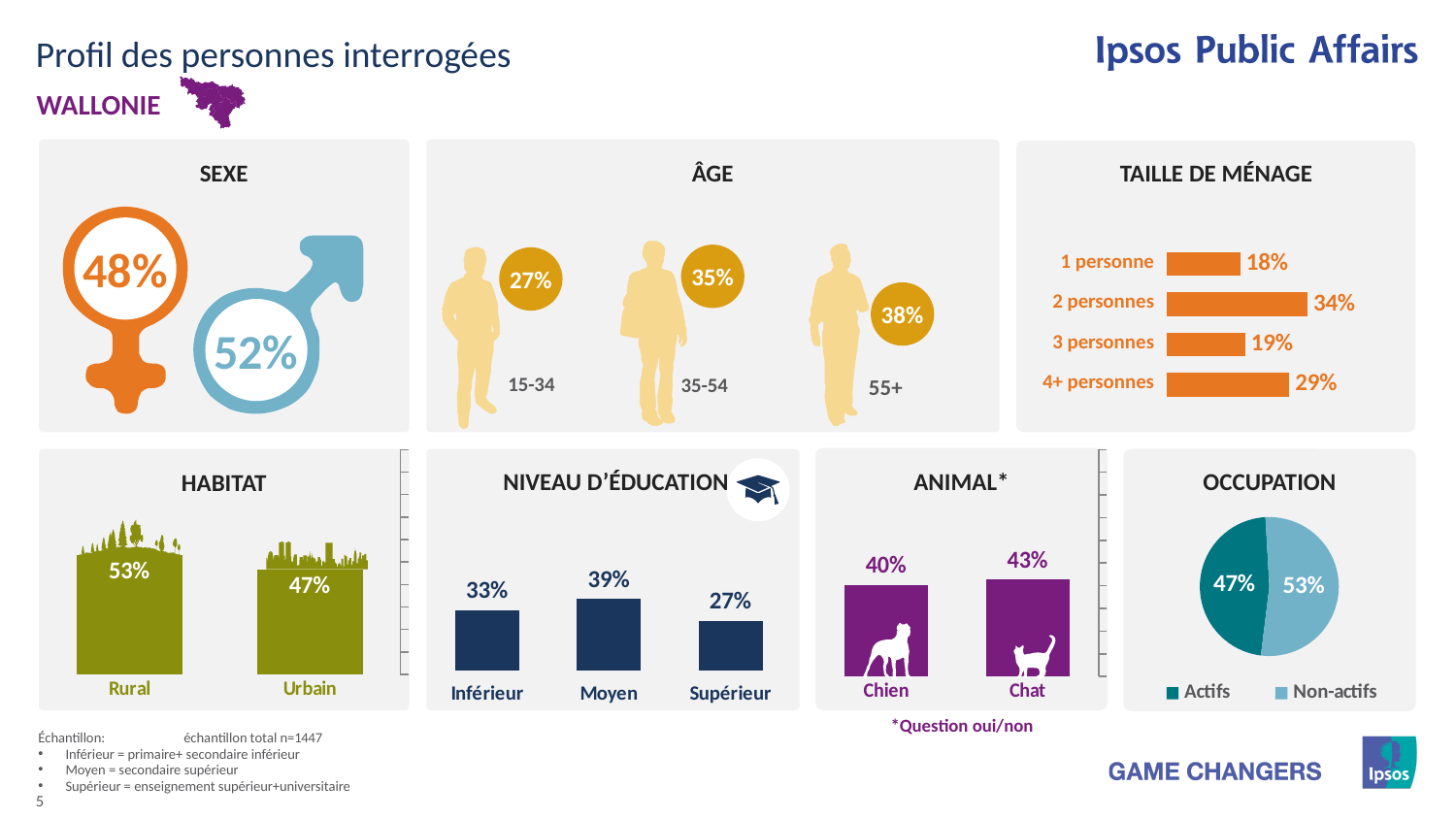
In the TAILLE DE MÉNAGE chart, what is the value for 2 personnes? 34% How many entries does the legend of the OCCUPATION pie chart list? 2 In the TAILLE DE MÉNAGE chart, which household size has the lowest value? 1 personne In the OCCUPATION pie chart, what share is Non-actifs? 53% In the HABITAT chart, what is the value for Rural? 53% What kind of chart is the TAILLE DE MÉNAGE chart? bar chart How many categories does the TAILLE DE MÉNAGE chart show? 4 In the ANIMAL chart, which is larger, Chien or Chat? Chat In the ANIMAL chart, what is the difference between Chat and Chien? 3% In the NIVEAU D'ÉDUCATION chart, which level has the highest value? Moyen In the TAILLE DE MÉNAGE chart, what is the difference between 4+ personnes and 3 personnes? 10% In the NIVEAU D'ÉDUCATION chart, what is the value for Supérieur? 27%